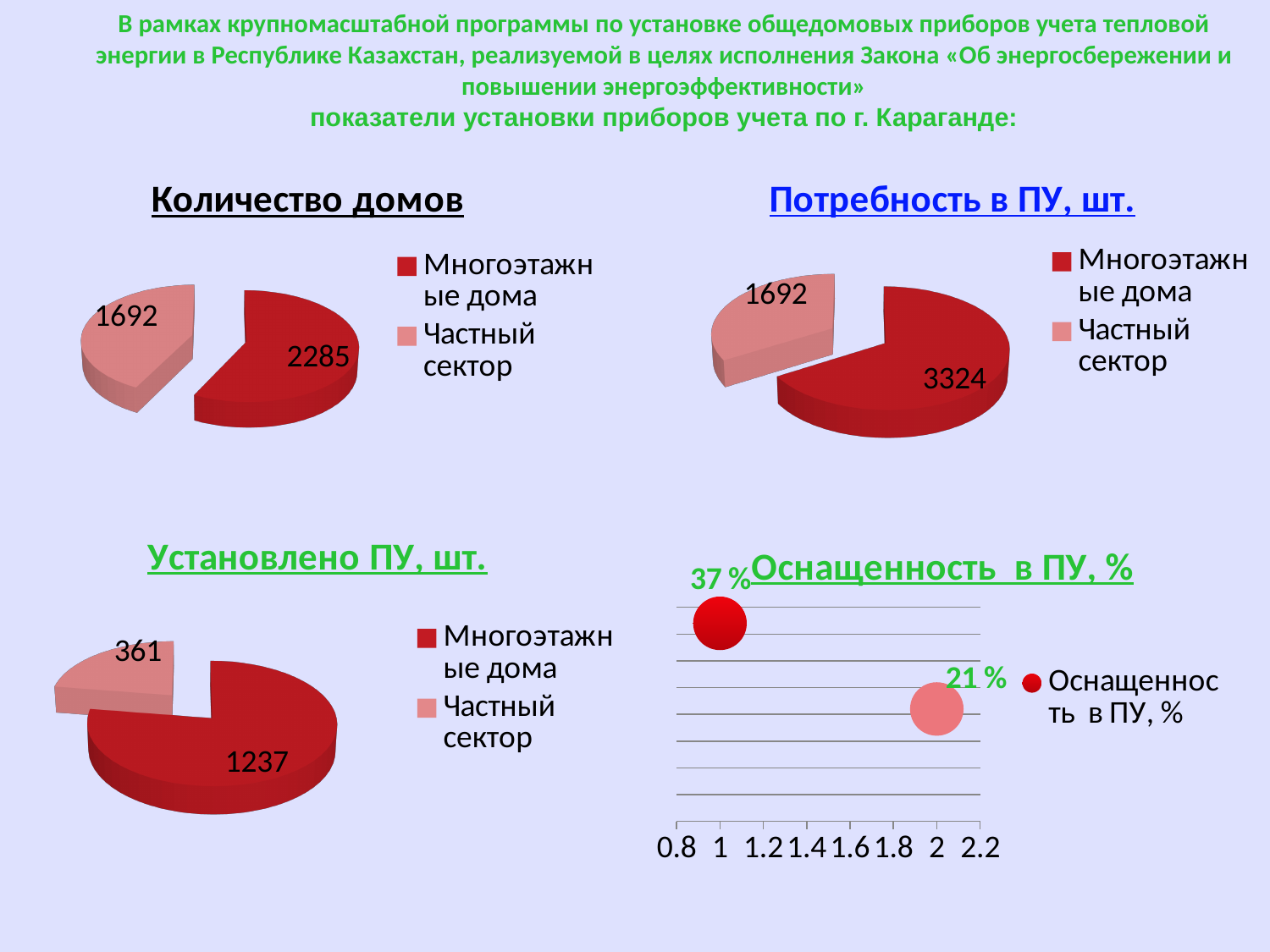
In the chart titled "Установлено ПУ, шт.", what is the value for Частный сектор? 361 How many series does the legend of the chart titled "Оснащенность в ПУ, %" list? 1 How many categories does the chart titled "Установлено ПУ, шт." show? 2 In the chart titled "Количество домов", which category has the larger value? Многоэтажные дома In the chart titled "Установлено ПУ, шт.", which category has the smallest value? Частный сектор In the chart titled "Установлено ПУ, шт.", what is the value for Многоэтажные дома? 1237 In the chart titled "Количество домов", what is the value for Частный сектор? 1692 In the chart titled "Потребность в ПУ, шт.", what is the difference between the values for Многоэтажные дома and Частный сектор? 1632 What type of chart is the chart titled "Количество домов"? Pie chart In the chart titled "Потребность в ПУ, шт.", what is the value for Многоэтажные дома? 3324 In the chart titled "Количество домов", what is the value for Многоэтажные дома? 2285 In the chart titled "Оснащенность в ПУ, %", what are the two data labels shown? 37 % and 21 %